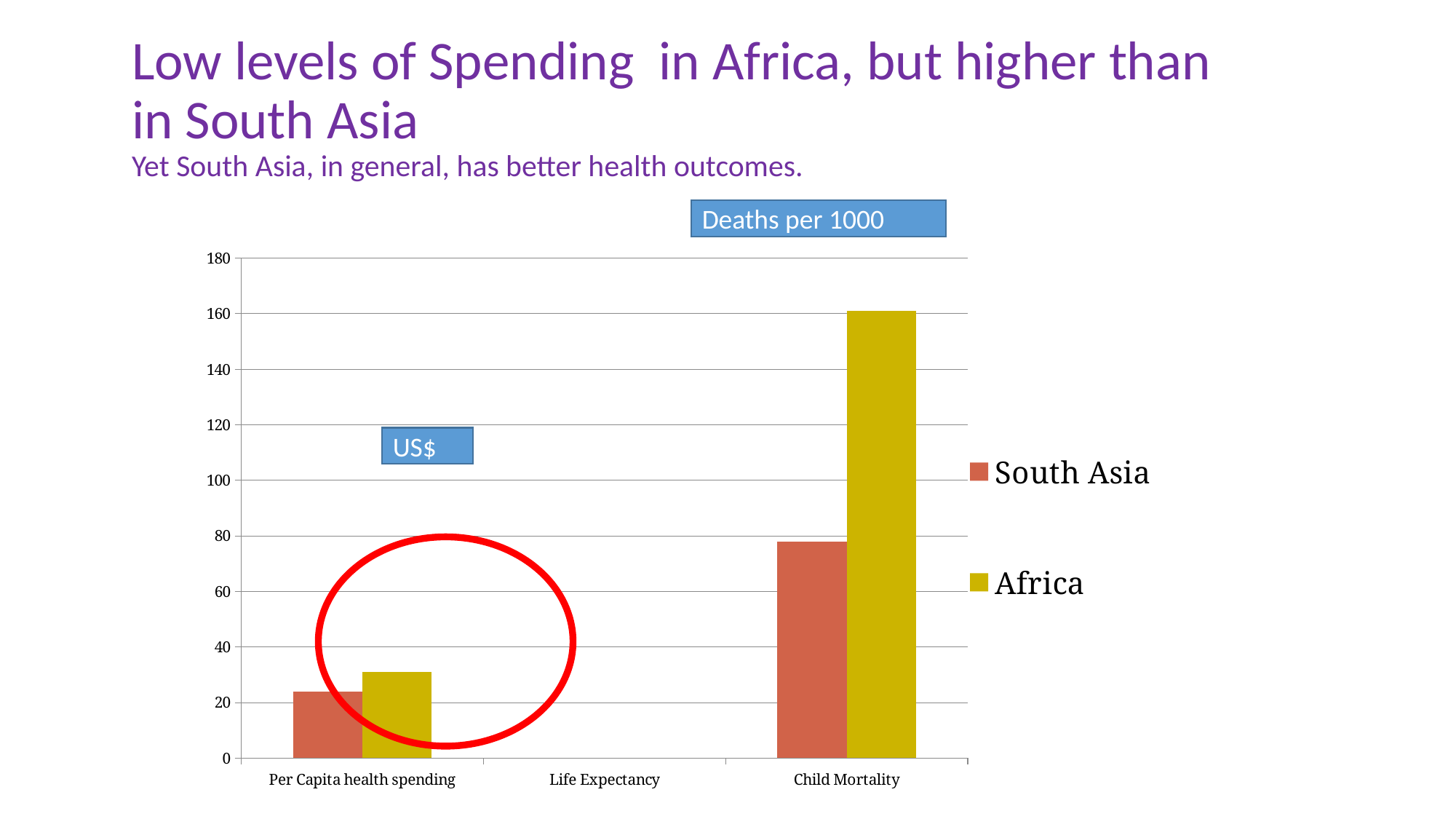
Is the South Asia value for Child Mortality greater or less than 100? less What kind of chart is shown on the slide? bar chart Which category on the x axis has no bars plotted? Life Expectancy How many categories are shown on the x axis of the chart? 3 What colour are the bars for the Africa series? yellow Which series has the higher value for Per Capita health spending, South Asia or Africa? Africa Which series has the higher value for Child Mortality, South Asia or Africa? Africa Is the Africa value for Per Capita health spending greater or less than 40? less Is the Africa value for Child Mortality greater or less than 140? greater Which category has the tallest bar for Africa? Child Mortality How many series does the chart legend list? 2